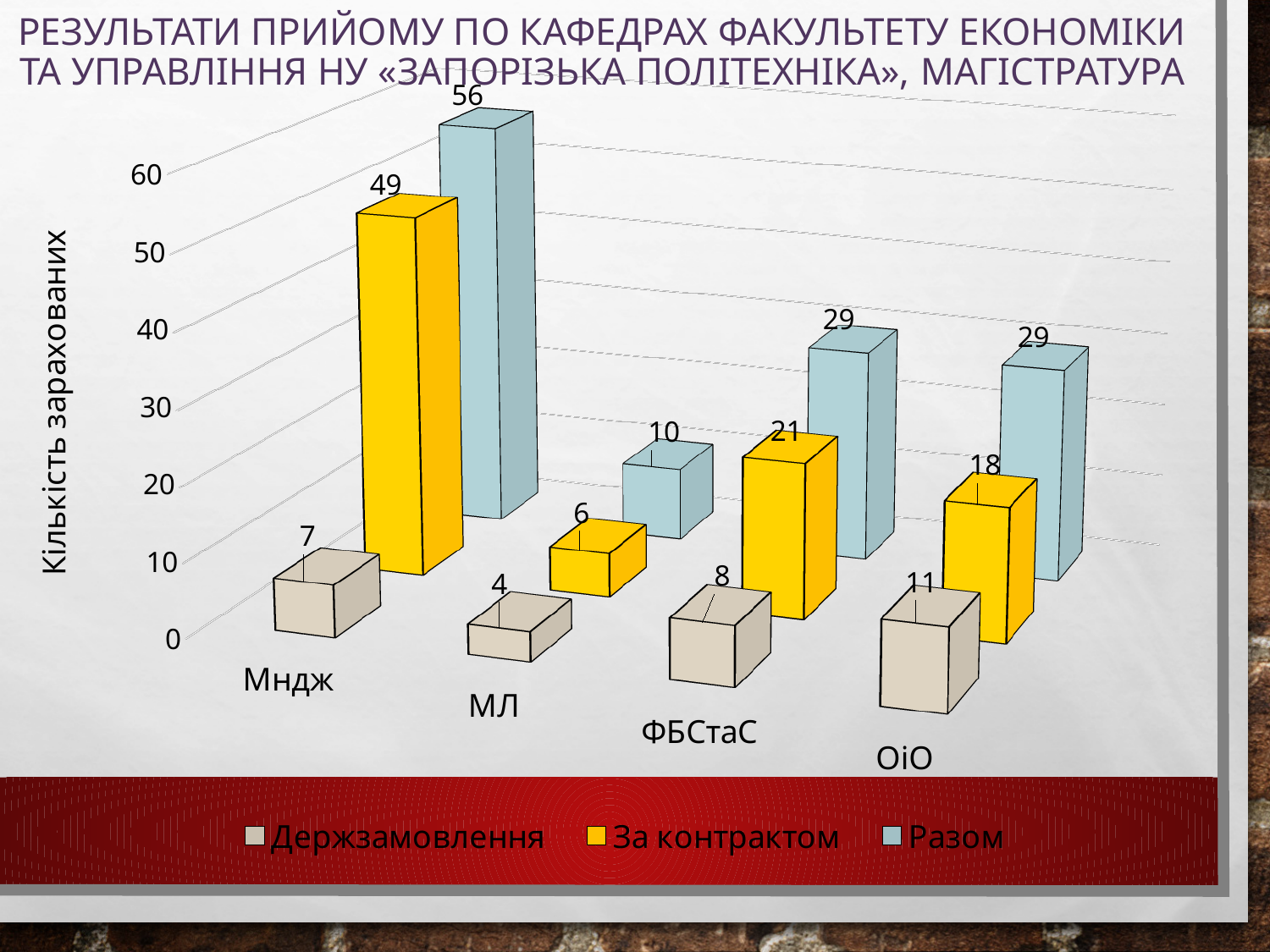
Which category has the lowest value for Разом? МЛ What is the value of Держзамовлення for ОіО? 11 What is the difference between За контрактом for Мндж and За контрактом for ОіО? 31 What kind of chart is shown on the slide? bar chart How many series does the legend list? 3 Which is larger: Держзамовлення for ФБСтаС or Держзамовлення for ОіО? Держзамовлення for ОіО What is the label of the vertical axis? Кількість зарахованих What is the value of Держзамовлення for МЛ? 4 How many categories are shown on the x axis? 4 Which category has the highest value for За контрактом? Мндж What is the value of За контрактом for ФБСтаС? 21 What is the value of Разом for Мндж? 56